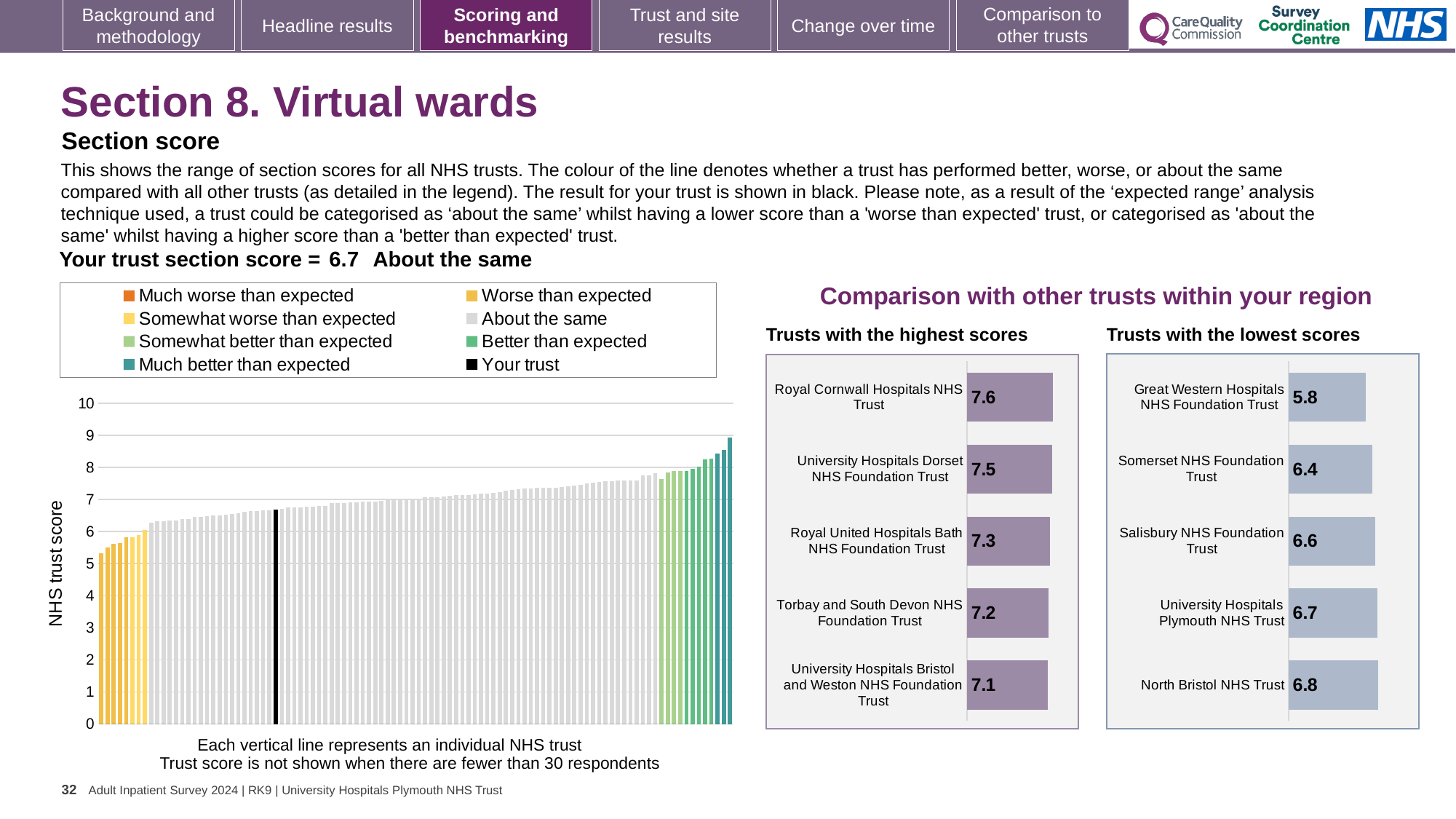
How many entries does the legend of the 'NHS trust score' chart on the left list? 8 In the 'NHS trust score' chart on the left, do the values rise or fall from left to right? Rise In the 'Trusts with the highest scores' chart, which trust has the lowest score? University Hospitals Bristol and Weston NHS Foundation Trust What kind of chart is the 'NHS trust score' chart on the left of the slide? Bar chart In the 'Trusts with the lowest scores' chart, which trust has the highest score? North Bristol NHS Trust In the 'Trusts with the lowest scores' chart, which has the larger score: Salisbury NHS Foundation Trust or Great Western Hospitals NHS Foundation Trust? Salisbury NHS Foundation Trust In the 'Trusts with the lowest scores' chart, what is the score for University Hospitals Plymouth NHS Trust? 6.7 In the 'Trusts with the lowest scores' chart, what is the score for Somerset NHS Foundation Trust? 6.4 In the 'NHS trust score' chart on the left, is the value of the tallest bar greater or less than 8? greater In the 'Trusts with the highest scores' chart, what is the score for Royal Cornwall Hospitals NHS Trust? 7.6 How many trusts are shown in the 'Trusts with the lowest scores' chart? 5 In the 'Trusts with the highest scores' chart, what is the difference between the scores of Royal Cornwall Hospitals NHS Trust and Torbay and South Devon NHS Foundation Trust? 0.4